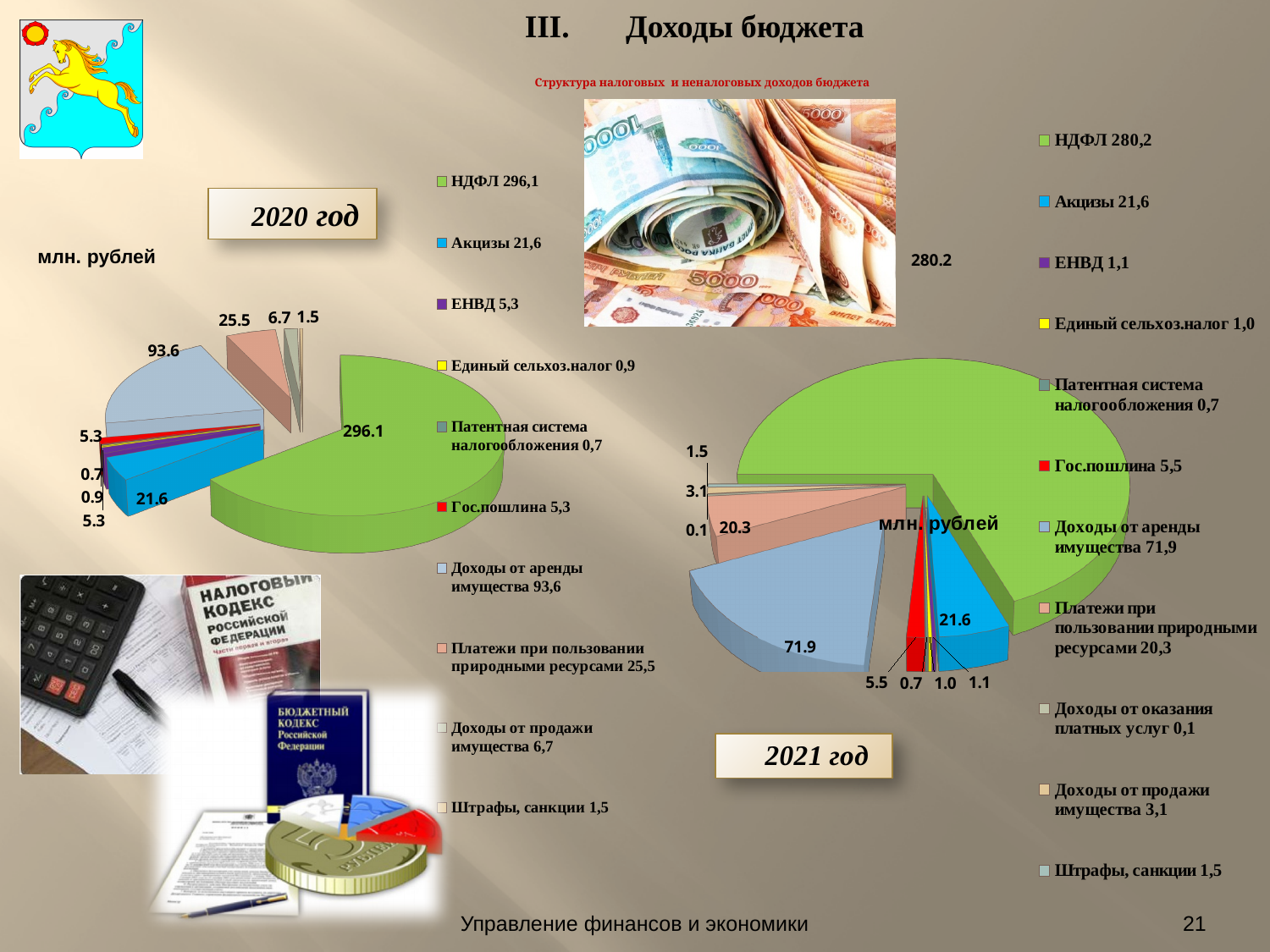
How many categories does the 2021 год pie chart legend list? 11 What type of chart is used for the 2020 год data? Pie chart What unit is stated for the values in the 2020 год chart? млн. рублей In the 2020 год pie chart, what is the value for Платежи при пользовании природными ресурсами? 25.5 In the 2021 год pie chart, what is the difference between Акцизы and Платежи при пользовании природными ресурсами? 1.3 How much larger is НДФЛ in the 2020 год chart than in the 2021 год chart? 15.9 In the 2020 год pie chart, which category has the largest value? НДФЛ In the 2020 год pie chart, what is the value for НДФЛ? 296.1 In the 2020 год pie chart, which is larger: Доходы от аренды имущества or Платежи при пользовании природными ресурсами? Доходы от аренды имущества In the 2021 год pie chart, which category has the smallest value? Доходы от оказания платных услуг In the 2021 год pie chart, what is the value for Доходы от аренды имущества? 71.9 In the 2021 год pie chart, what is the value for Гос.пошлина? 5.5